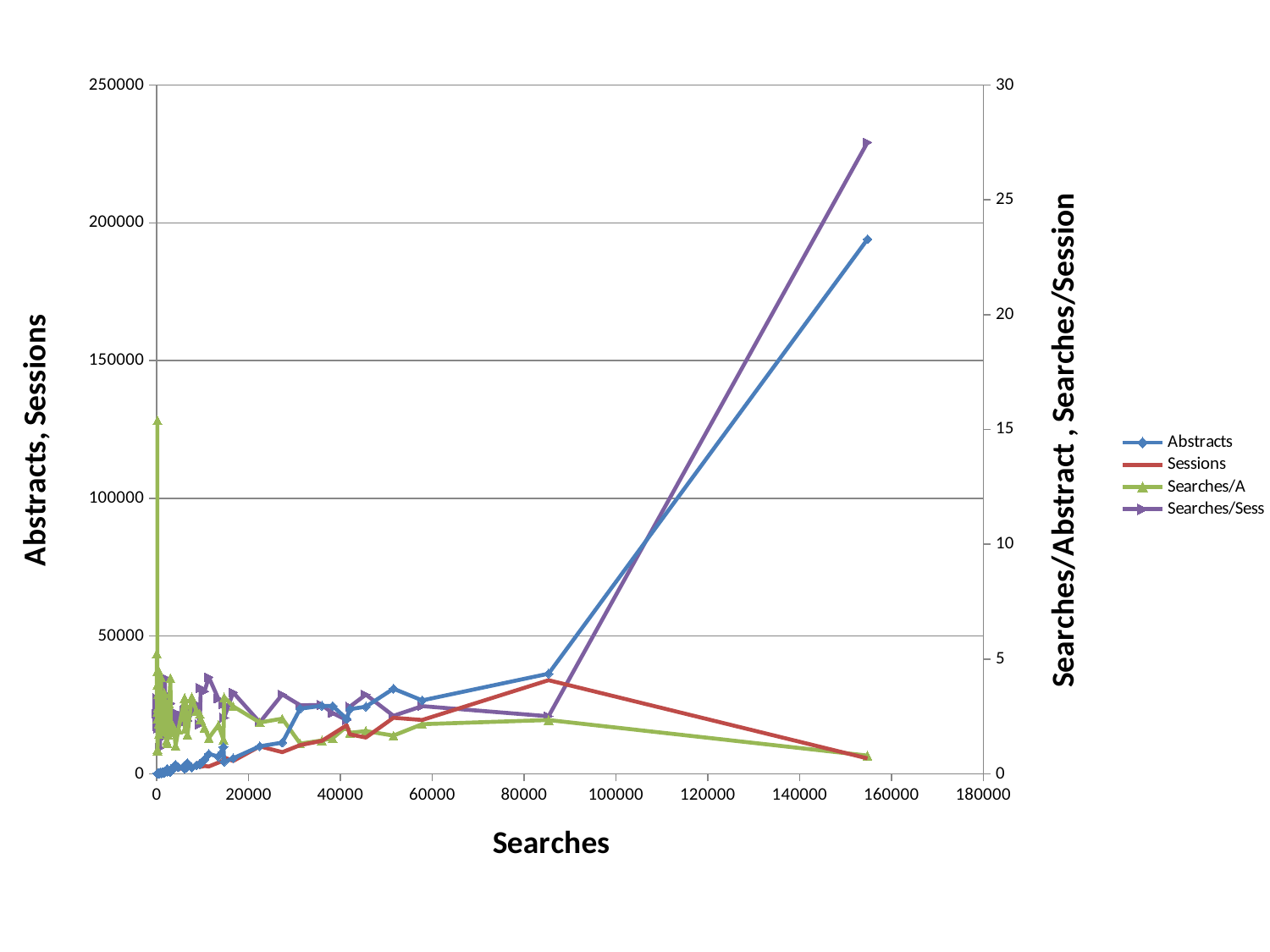
What is the title of the right-hand y axis? Searches/Abstract , Searches/Session Does the Abstracts series rise or fall between about 85000 and 155000 searches? rise Is the value of the Abstracts series at its rightmost point (around 155000 searches) greater or less than 150000? greater Does the Sessions series rise or fall between about 85000 and 155000 searches? fall Is the value of the Searches/A series at its rightmost point (around 155000 searches) greater or less than 5 on the right axis? less Is the value of the Sessions series at its rightmost point (around 155000 searches) greater or less than 50000? less What kind of chart is shown on the slide? line chart At the rightmost point (around 155000 searches), which is larger: Abstracts or Sessions? Abstracts What is the title of the x axis? Searches How many series does the legend list? 4